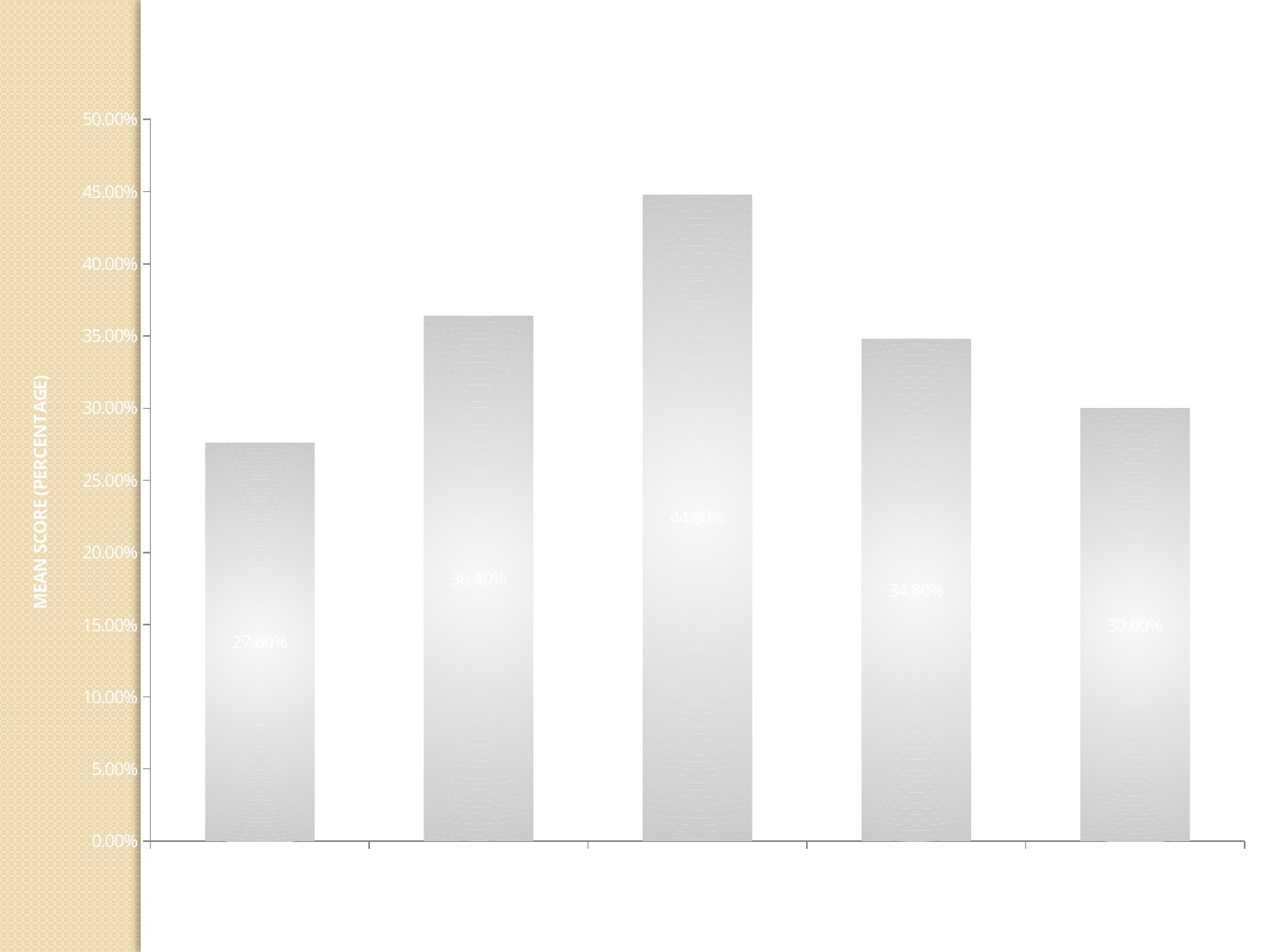
Which bar has the lowest value? the first (leftmost) bar, 27.60% Which is larger, the value of the second bar or the value of the fourth bar? the second bar (36.40%) What is the value shown on the last (rightmost) bar? 30.00% What is the value shown on the middle (third) bar? 44.80% What is the value shown on the second bar from the left? 36.40% What is the title of the vertical axis? MEAN SCORE (PERCENTAGE) What is the difference between the highest bar (44.80%) and the lowest bar (27.60%)? 17.20% What is the value shown on the fourth bar from the left? 34.80% Which bar has the highest value? the third (middle) bar, 44.80% What is the value shown on the first (leftmost) bar? 27.60% How many bars are plotted in the chart? 5 What type of chart is shown on the slide? bar chart